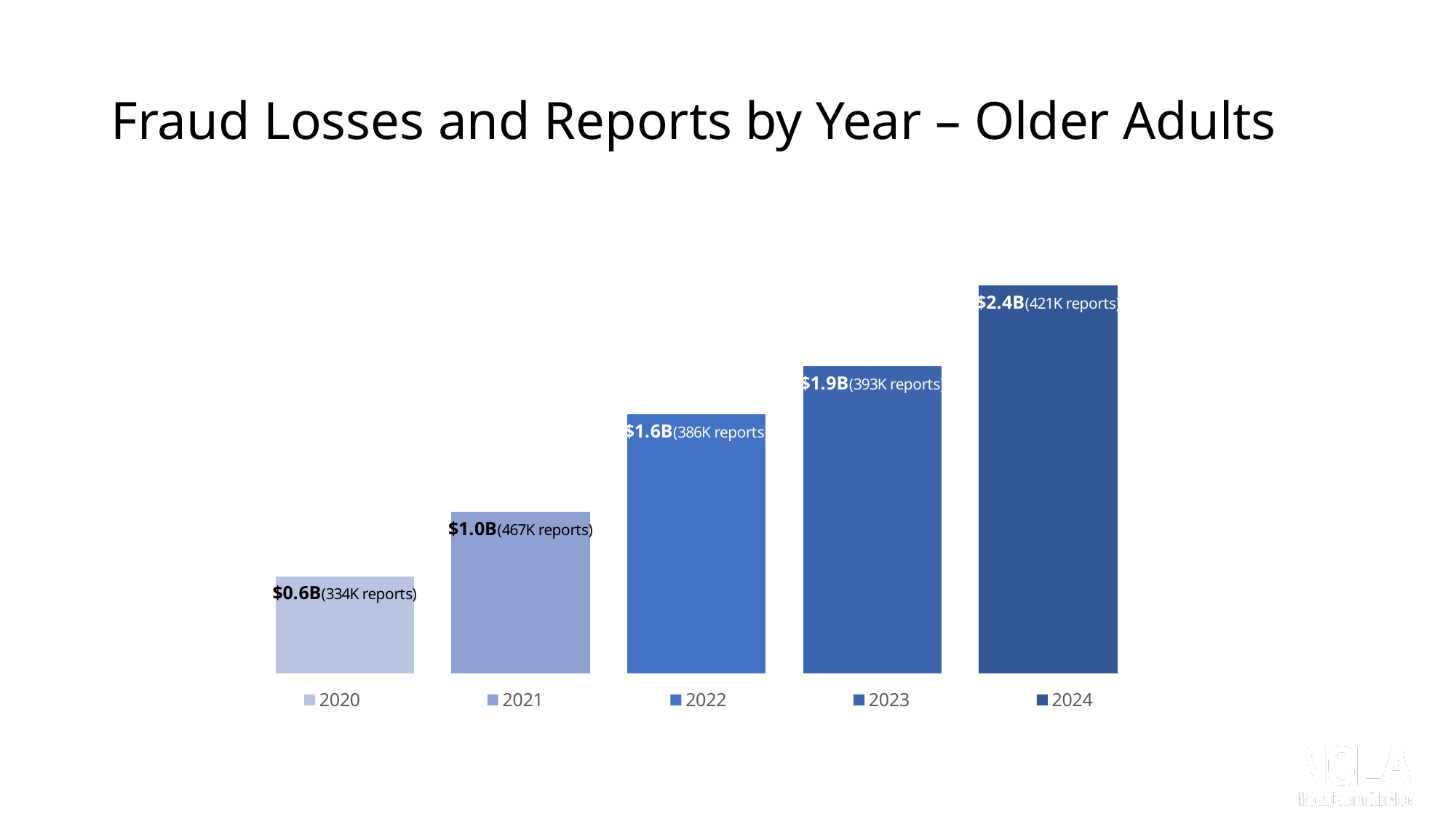
Which year had higher fraud losses, 2022 or 2021? 2022 How many reports are shown for 2024? 421K reports Which year has the lowest fraud losses? 2020 How many years are shown in the chart? 5 Do fraud losses rise or fall from 2020 to 2024? Rise How many reports are shown for 2021? 467K reports What is the difference in fraud losses between 2024 and 2020? $1.8B What were the fraud losses for 2020? $0.6B What is the title of the chart? Fraud Losses and Reports by Year – Older Adults What kind of chart is shown on the slide? Bar chart Which year has the highest fraud losses? 2024 What were the fraud losses for 2023? $1.9B